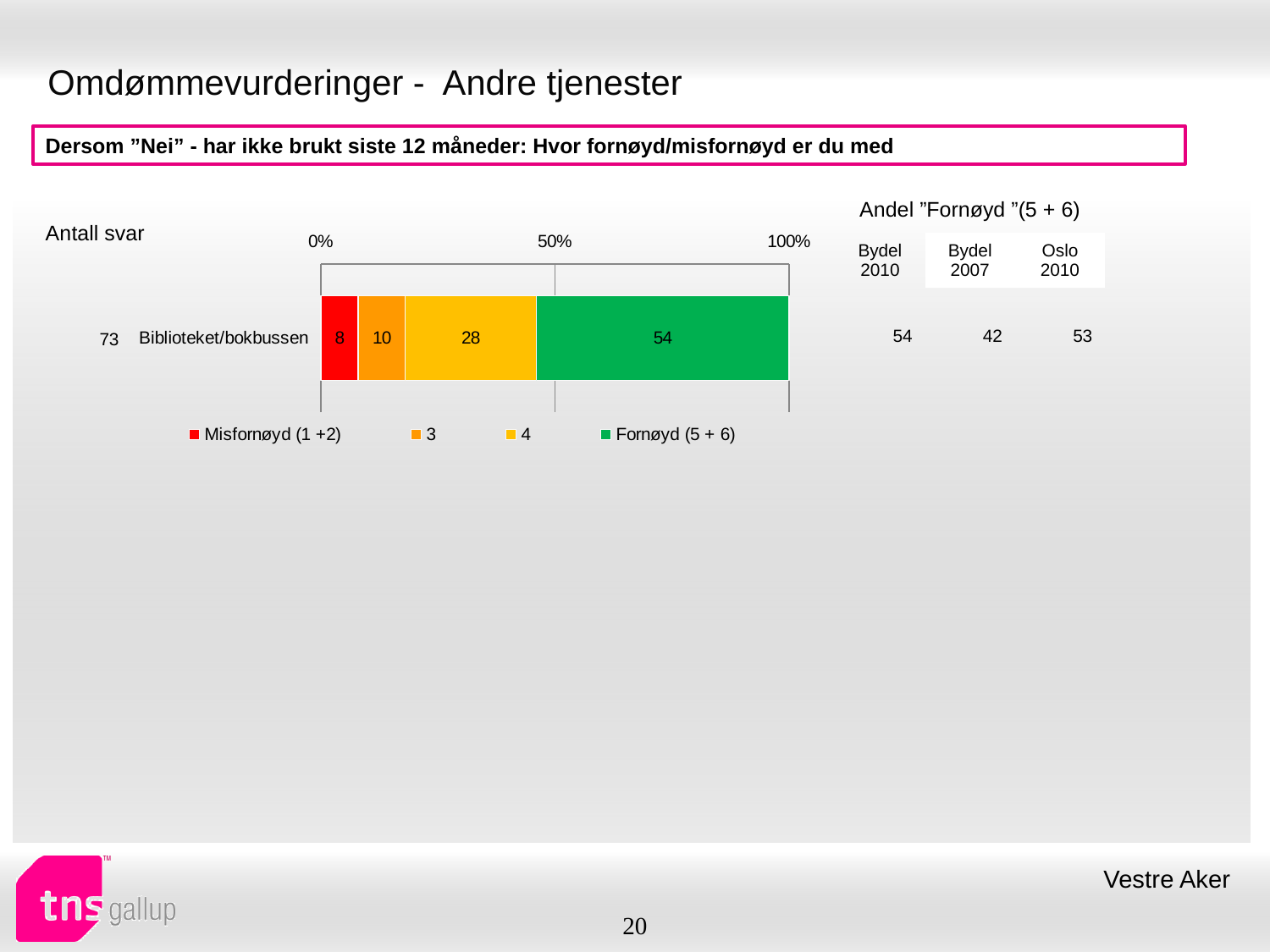
What is the value of the segment labelled 4 for Biblioteket/bokbussen? 28 Which segment of the Biblioteket/bokbussen bar has the smallest value? Misfornøyd (1 +2) How many series does the legend list? 4 What is the value of the Fornøyd (5 + 6) segment for Biblioteket/bokbussen? 54 What kind of chart is shown on the slide? Stacked bar chart What is the value of the segment labelled 3 for Biblioteket/bokbussen? 10 What is the difference between the Fornøyd (5 + 6) segment and the segment labelled 4 for Biblioteket/bokbussen? 26 Which is larger for Biblioteket/bokbussen: the segment labelled 3 or the segment labelled 4? 4 How many categories are plotted in the chart? 1 Which segment of the Biblioteket/bokbussen bar has the largest value? Fornøyd (5 + 6) What is the total of all segments in the Biblioteket/bokbussen bar? 100 What is the value of the Misfornøyd (1 +2) segment for Biblioteket/bokbussen? 8